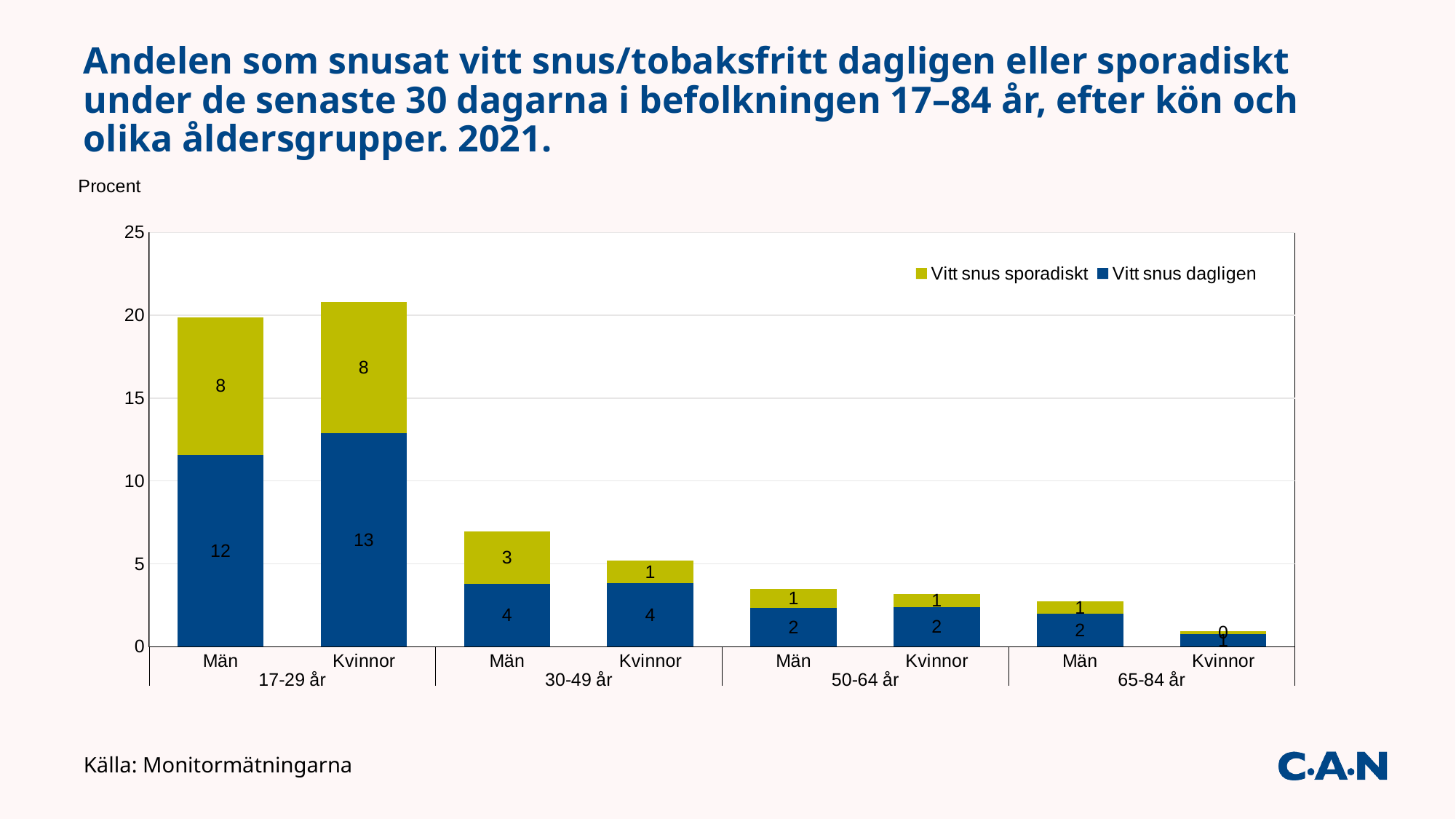
Which is larger, the Vitt snus sporadiskt value for Män aged 30-49 år or for Kvinnor aged 30-49 år? Män 30-49 år What kind of chart is shown on the slide? Stacked bar chart How many stacked bars are shown in the chart? 8 What is the value for Vitt snus sporadiskt among Män aged 30-49 år? 3 Is the total stacked bar for Kvinnor aged 17-29 år greater or less than 20? greater What is the difference between the Vitt snus dagligen values for Kvinnor and Män aged 17-29 år? 1 What is the value for Vitt snus dagligen among Män aged 17-29 år? 12 Which group has the lowest value for Vitt snus sporadiskt? Kvinnor 65-84 år What is the value for Vitt snus sporadiskt among Kvinnor aged 17-29 år? 8 Which group has the highest value for Vitt snus dagligen? Kvinnor 17-29 år What is the value for Vitt snus dagligen among Kvinnor aged 65-84 år? 1 How many series does the legend list? 2